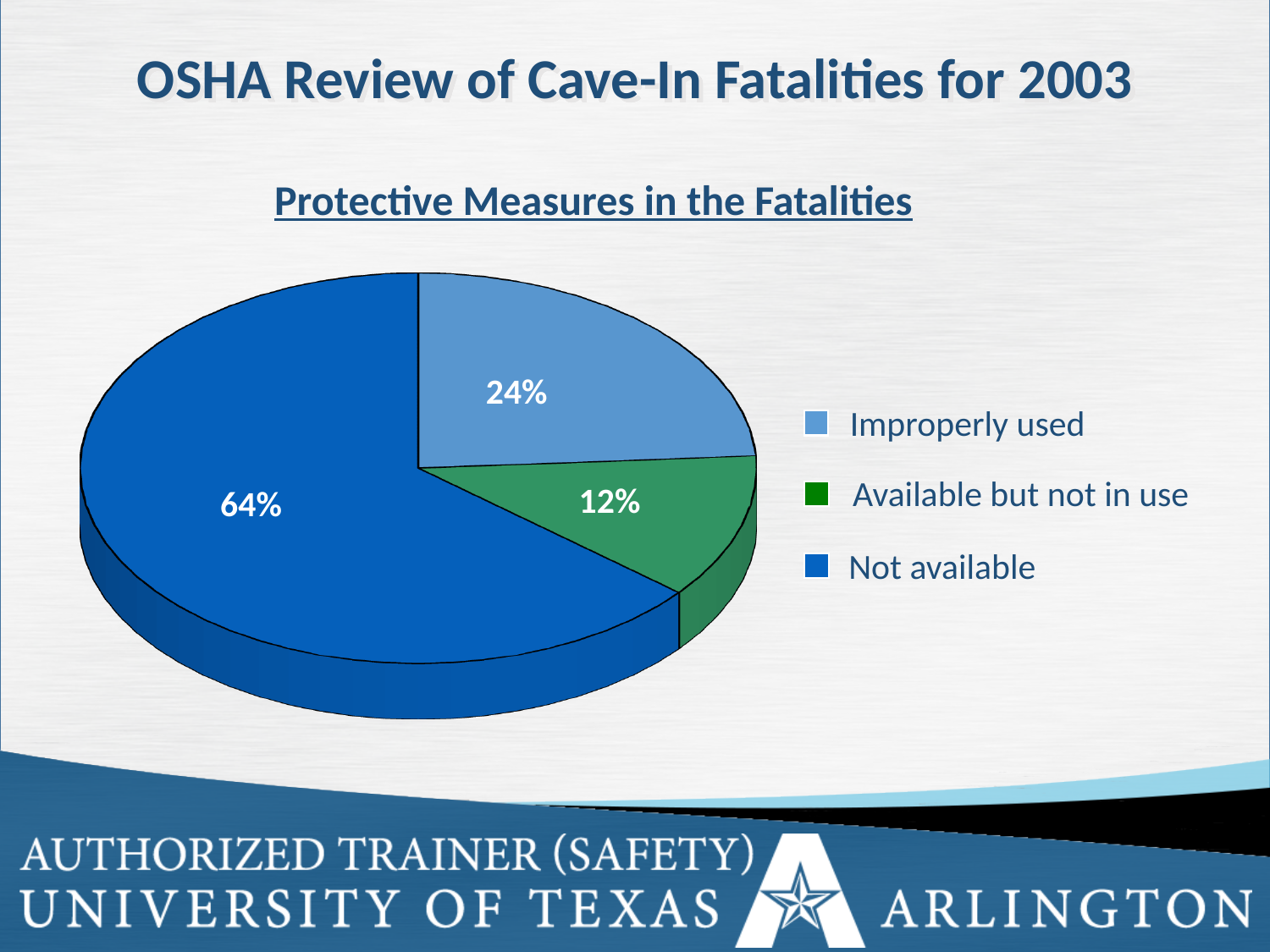
Which category has the largest slice of the pie? Not available What is the difference in percentage points between "Not available" and "Improperly used"? 40 What is the difference in percentage points between "Improperly used" and "Available but not in use"? 12 Which category has the smallest slice of the pie? Available but not in use What is the title of the pie chart? Protective Measures in the Fatalities What share of the pie is labelled "Improperly used"? 24% What share of the pie is labelled "Not available"? 64% What share of the pie is labelled "Available but not in use"? 12% Which is larger, the slice for "Improperly used" or the slice for "Available but not in use"? Improperly used What kind of chart is shown on the slide? Pie chart What colour is the slice for "Available but not in use"? Green How many categories does the pie chart have? 3